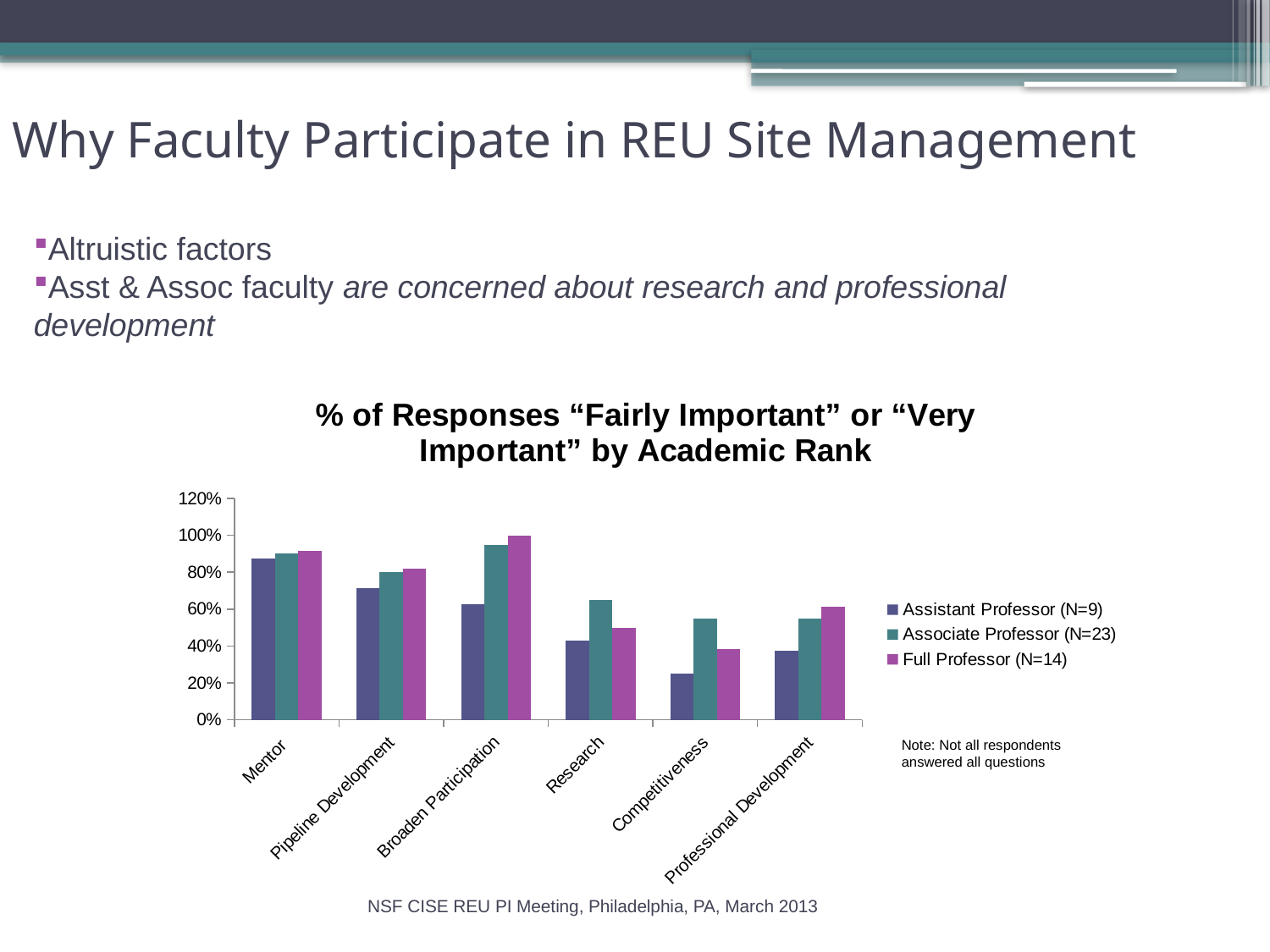
For the Associate Professor series, which category has the highest value? Broaden Participation What kind of chart is shown on the slide? bar chart How many series does the legend list? 3 Is the Assistant Professor value for Research greater or less than 60%? less For the Assistant Professor series, which category has the lowest value? Competitiveness Is the Full Professor value for Mentor greater or less than 80%? greater According to the legend, how many Associate Professor respondents were there? N=23 For Research, which is larger: the Associate Professor value or the Full Professor value? Associate Professor For Competitiveness, which is larger: the Assistant Professor value or the Full Professor value? Full Professor Is the Associate Professor value for Broaden Participation greater or less than 80%? greater What is the title of the chart? % of Responses "Fairly Important" or "Very Important" by Academic Rank How many categories are shown along the x axis? 6